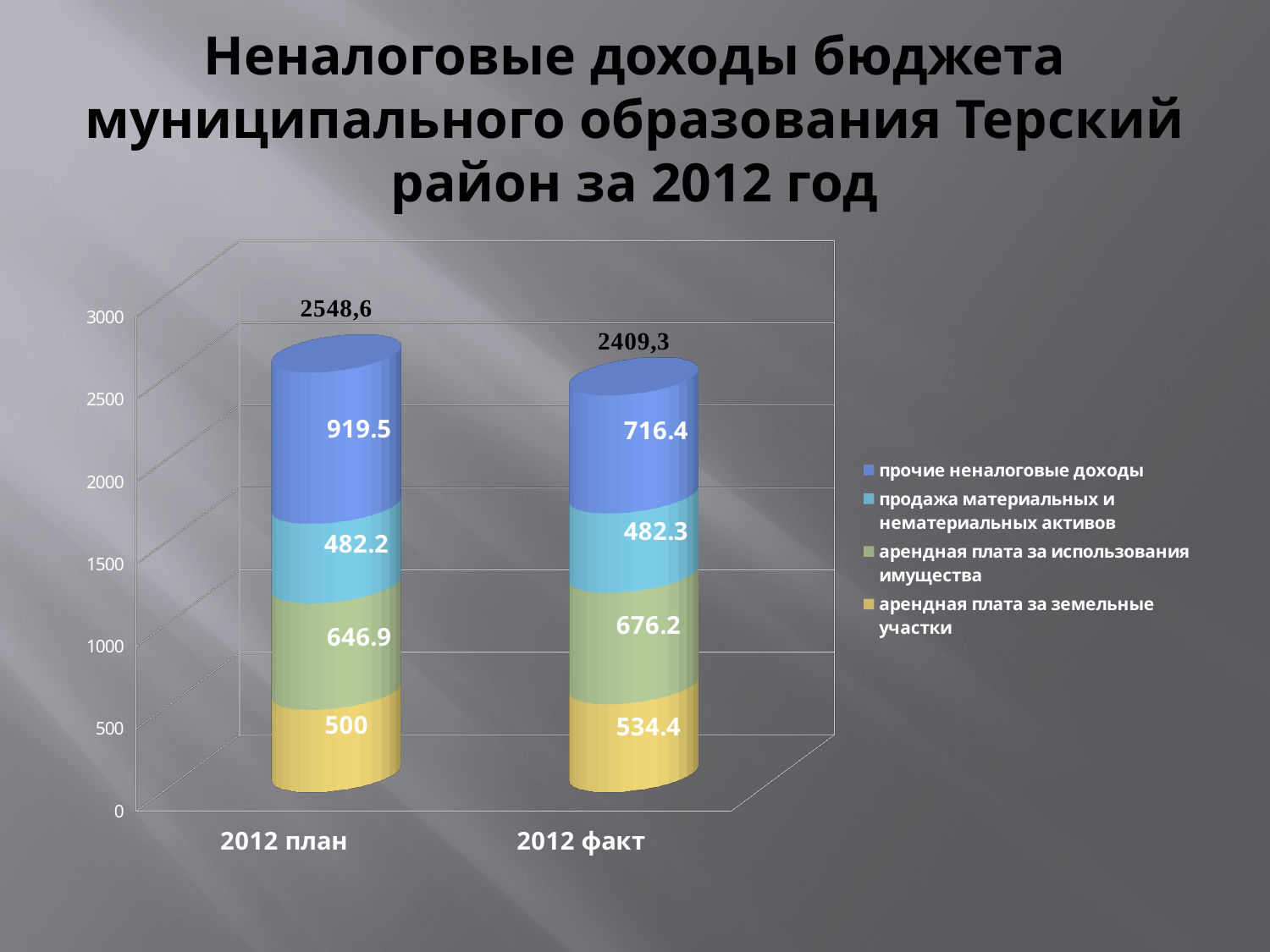
What is the value of «арендная плата за использования имущества» for «2012 факт»? 676.2 What is the total of the stacked bar for «2012 факт»? 2409,3 What is the value of «арендная плата за земельные участки» for «2012 факт»? 534.4 What is the value of «продажа материальных и нематериальных активов» for «2012 план»? 482.2 Which category has the higher total, «2012 план» or «2012 факт»? 2012 план How many series does the legend list? 4 What is the difference between «прочие неналоговые доходы» for «2012 план» and for «2012 факт»? 203.1 What is the value of «прочие неналоговые доходы» for «2012 план»? 919.5 What is the total of the stacked bar for «2012 план»? 2548,6 Which series has the largest value in the «2012 факт» bar? прочие неналоговые доходы Which series has the smallest value in the «2012 план» bar? продажа материальных и нематериальных активов What kind of chart is shown on the slide? Stacked bar chart